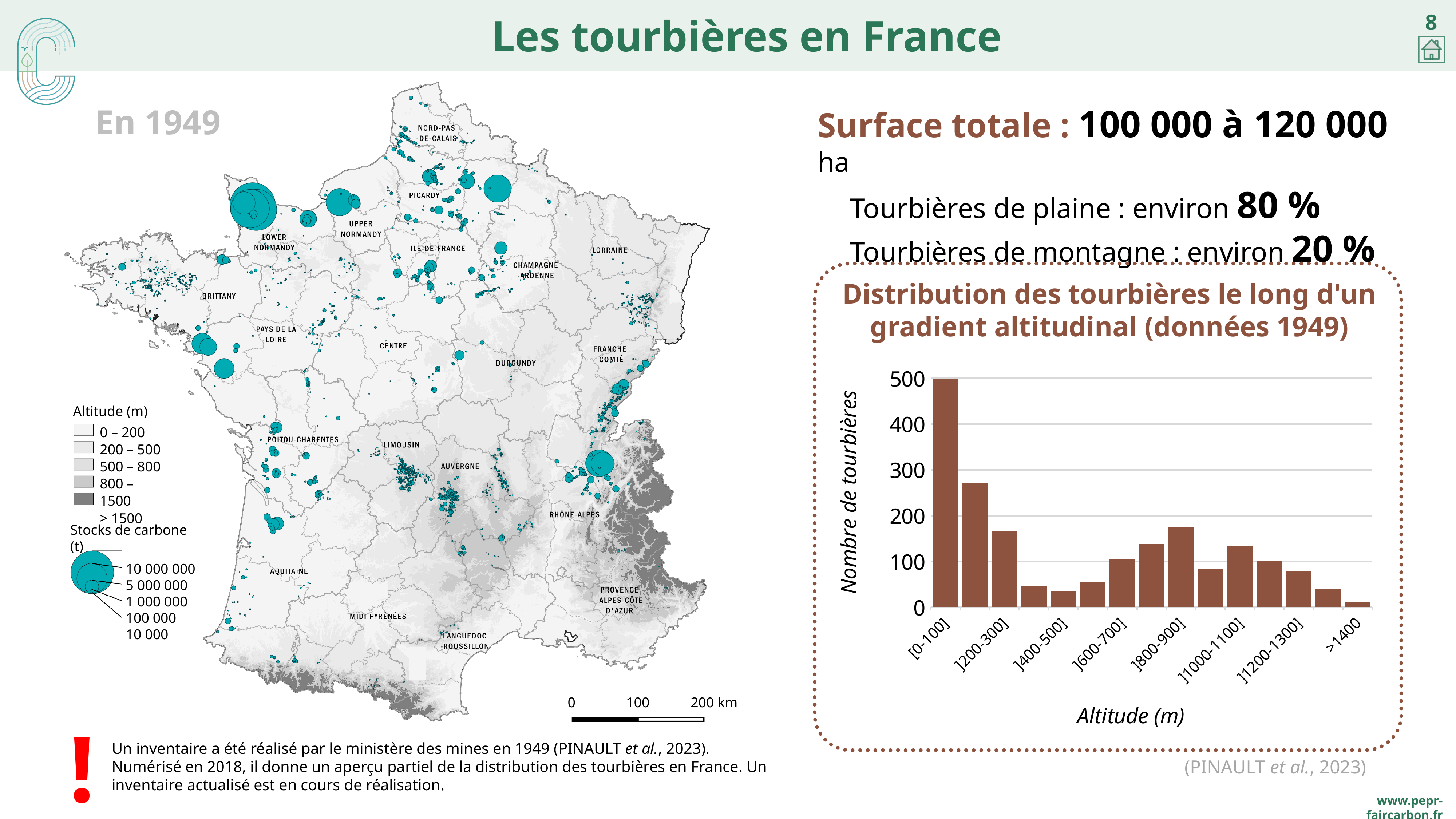
What kind of chart is 'Distribution des tourbières le long d'un gradient altitudinal (données 1949)'? bar chart In the bar chart, is the value for ]200-300] greater or less than 200? less In the bar chart, is the value for [0-100] greater or less than 400? greater In the bar chart, is the value for ]400-500] greater or less than 100? less In the bar chart, which is larger: the value for ]200-300] or the value for ]400-500]? ]200-300] What is the label of the y axis of the bar chart? Nombre de tourbières In the bar chart, which altitude class has the highest number of tourbières? [0-100] In the bar chart, do the values rise or fall from [0-100] to ]400-500]? fall In the bar chart, which altitude class has the lowest number of tourbières? >1400 How many bars are plotted in the bar chart? 15 In the bar chart, which is larger: the value for ]800-900] or the value for ]1200-1300]? ]800-900]